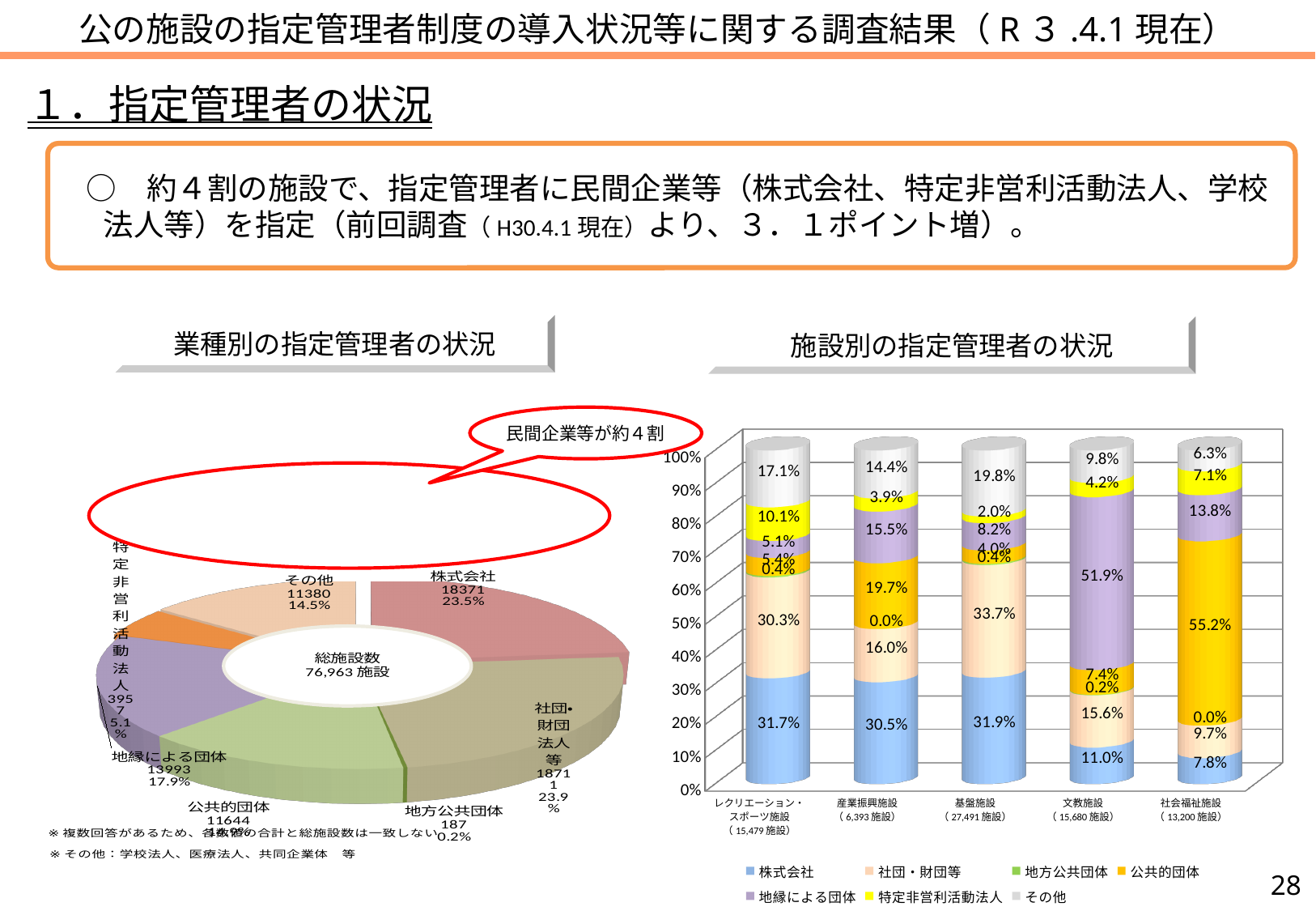
In the stacked bar chart 施設別の指定管理者の状況, how many series does the legend list? 7 In the pie chart 業種別の指定管理者の状況, what is the number of facilities shown for 地縁による団体? 13993 In the stacked bar chart 施設別の指定管理者の状況, what is the difference between the 株式会社 values for 基盤施設 and 社会福祉施設? 24.1% In the stacked bar chart 施設別の指定管理者の状況, what is the value for 公共的団体 in 社会福祉施設? 55.2% In the stacked bar chart 施設別の指定管理者の状況, what is the value for 地縁による団体 in 文教施設? 51.9% In the stacked bar chart 施設別の指定管理者の状況, what is the value for 株式会社 in レクリエーション・スポーツ施設? 31.7% In the pie chart 業種別の指定管理者の状況, what total number of facilities is shown in the centre? 76,963 施設 In the pie chart 業種別の指定管理者の状況, which category has the smallest share? 地方公共団体 What kind of chart is 施設別の指定管理者の状況? Stacked bar chart In the pie chart 業種別の指定管理者の状況, what percentage share is shown for 株式会社? 23.5% In the pie chart 業種別の指定管理者の状況, which is larger, the share for その他 or the share for 特定非営利活動法人? その他 In the stacked bar chart 施設別の指定管理者の状況, how many facility categories are shown on the x axis? 5